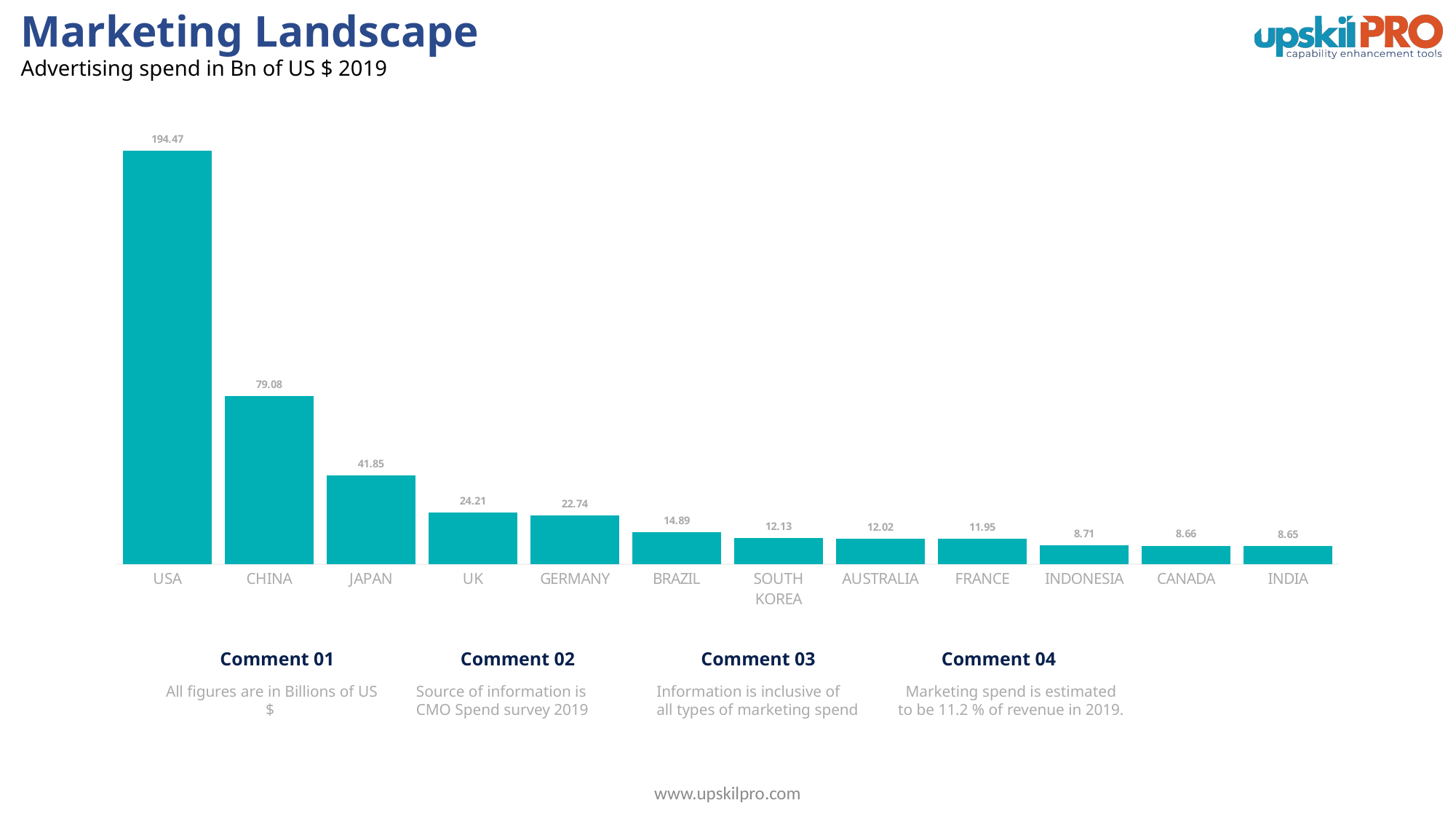
What is the advertising spend value shown for Japan? 41.85 What is the difference between the advertising spend of USA and China? 115.39 What is the advertising spend value shown for Indonesia? 8.71 Which country has the lowest advertising spend in the chart? India What is the advertising spend value shown for Germany? 22.74 Which has a larger advertising spend, China or Japan? China Which country has the highest advertising spend in the chart? USA Do the values rise or fall moving from left to right along the x axis? Fall How many countries are shown in the chart? 12 What kind of chart is shown on the slide? Bar chart What is the difference between the advertising spend of UK and Brazil? 9.32 What is the advertising spend value shown for USA? 194.47